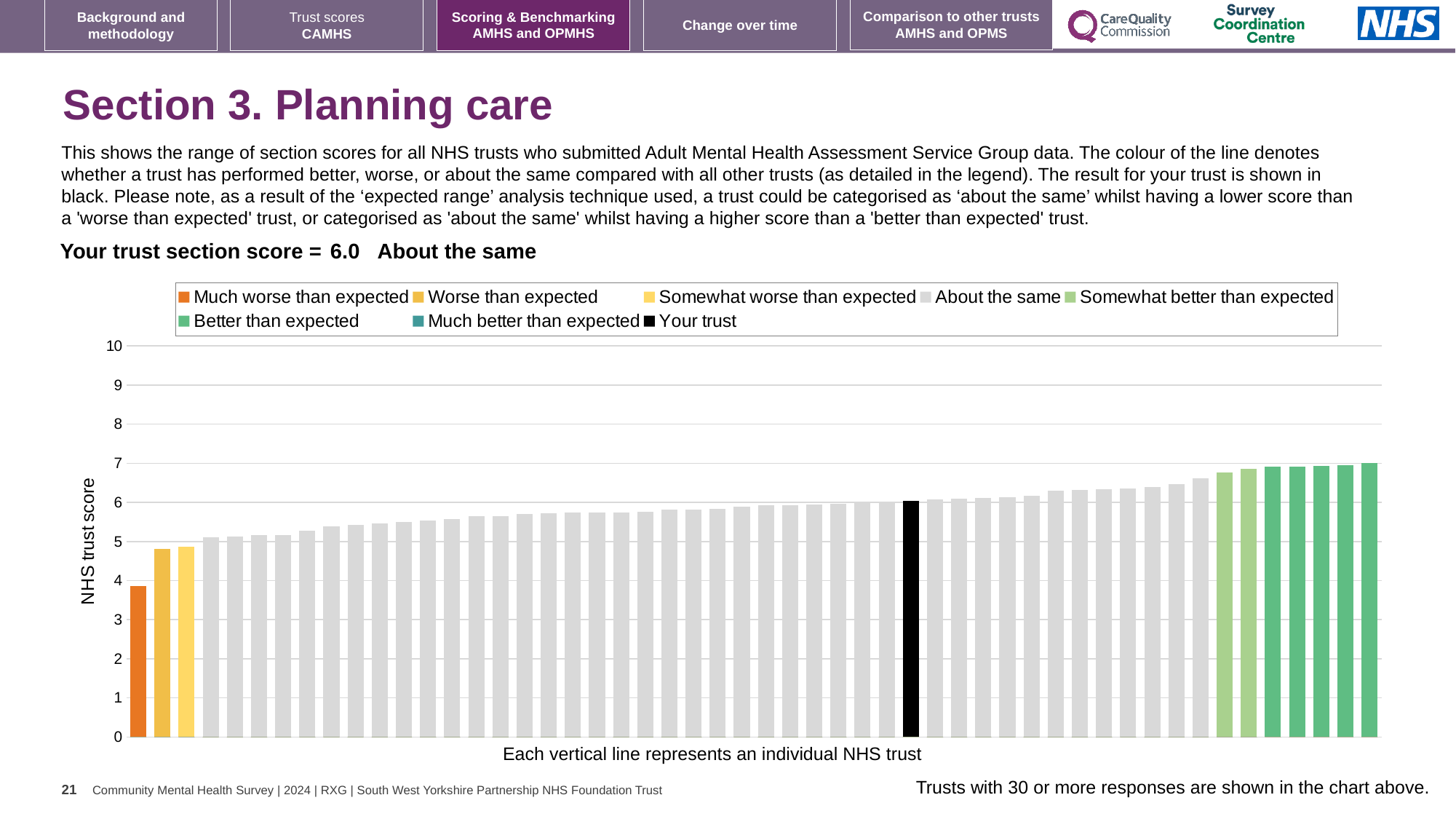
Is the value of the lowest bar (the orange 'Much worse than expected' trust) greater or less than 5? less Is the value for your trust (the black bar) greater or less than 5? greater How many bars are coloured as 'Worse than expected'? 1 What kind of chart is shown on the slide? bar chart Is the value of the highest bar on the chart greater or less than 6? greater What colour is the bar representing your trust? black What is the label on the vertical axis of the chart? NHS trust score Do the bar values rise or fall from left to right along the x axis? rise How many bars are coloured as 'Much worse than expected'? 1 What is the section score for your trust shown on the slide? 6.0 How many entries does the chart legend list? 8 What is the highest tick value shown on the vertical axis? 10